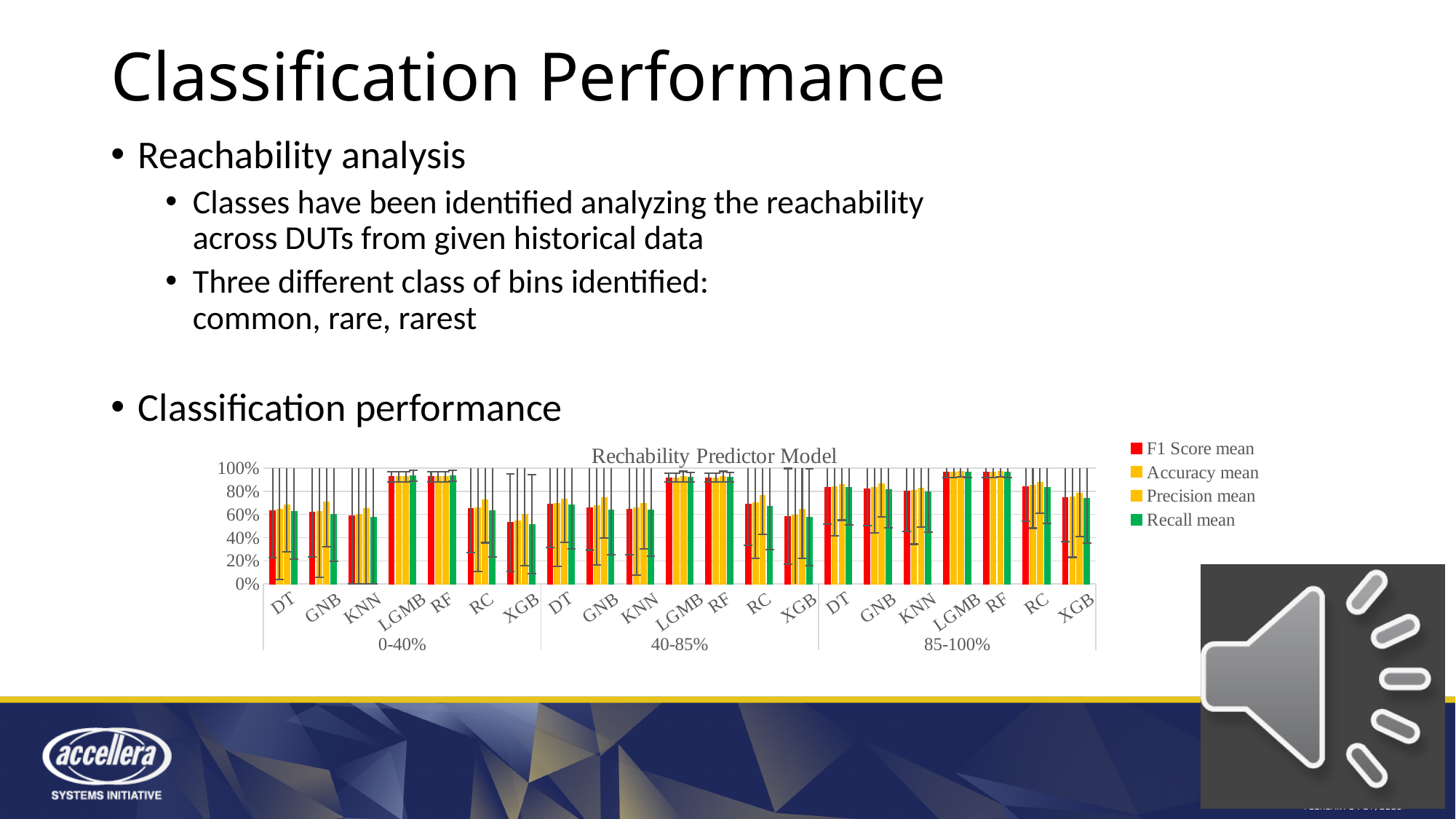
How many models are listed within each reachability group on the x axis? 7 How many reachability groups (0-40%, 40-85%, 85-100%) are shown along the x axis? 3 What is the title of the chart? Rechability Predictor Model Is the F1 Score mean for LGMB in the 0-40% group greater or less than 80%? greater In the 0-40% group, which has the larger F1 Score mean, LGMB or XGB? LGMB Which series is shown in green in the chart? Recall mean Is the F1 Score mean for KNN in the 0-40% group greater or less than 80%? less Is the F1 Score mean for RF in the 85-100% group greater or less than 80%? greater What kind of chart is shown on the slide? bar chart How many series does the chart's legend list? 4 In the 40-85% group, which model has the lowest F1 Score mean? XGB